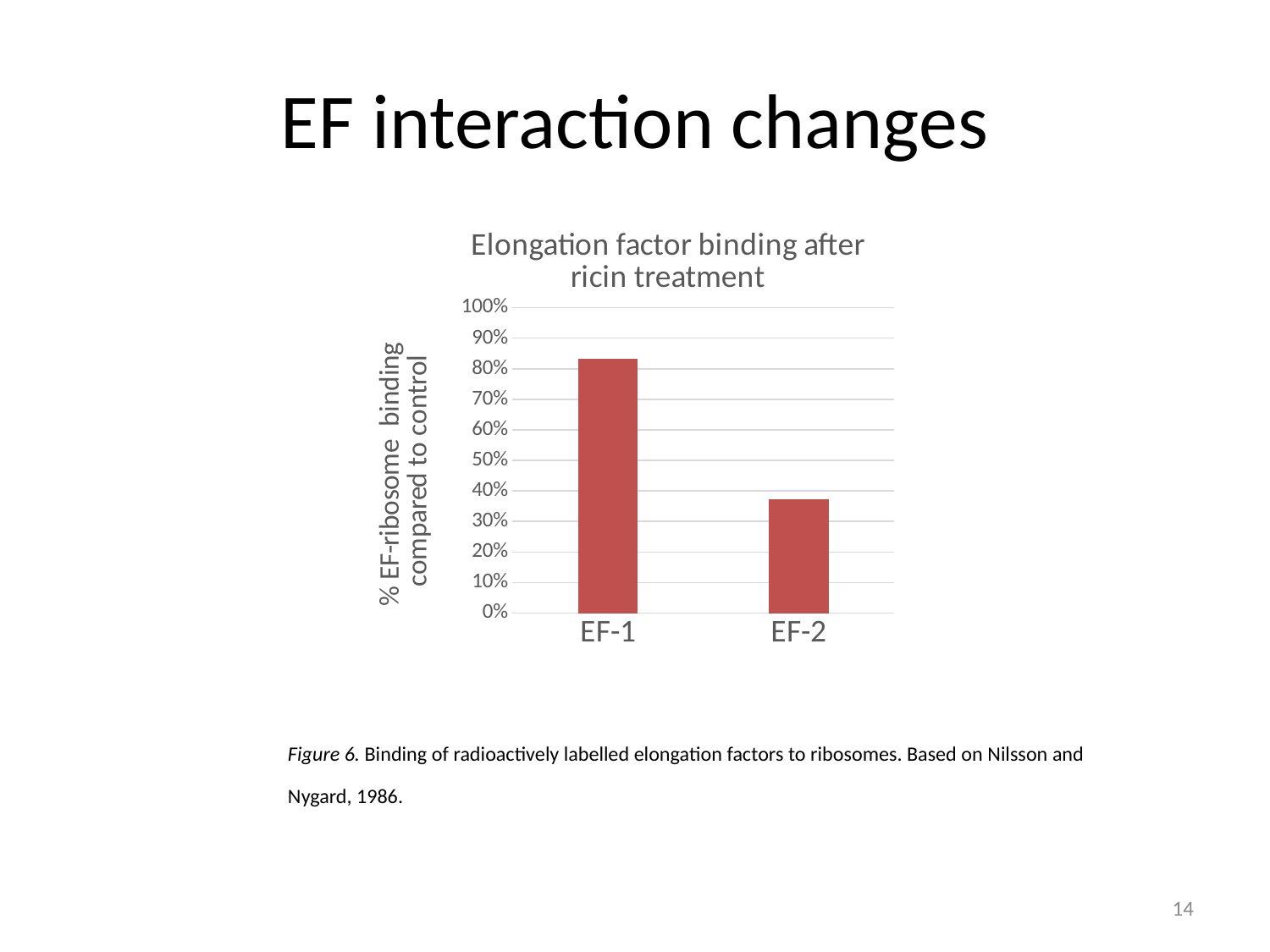
Which category has the lowest value? EF-2 How many categories are plotted on the x axis? 2 Which category has the highest value? EF-1 Do the values rise or fall from EF-1 to EF-2? fall What is the label of the y axis? % EF-ribosome binding compared to control What is the title of the chart? Elongation factor binding after ricin treatment Which has a larger value, EF-1 or EF-2? EF-1 Is the value for EF-1 greater or less than 80%? greater Is the value for EF-2 greater or less than 30%? greater Is the value for EF-1 greater or less than 90%? less What kind of chart is shown on the slide? bar chart